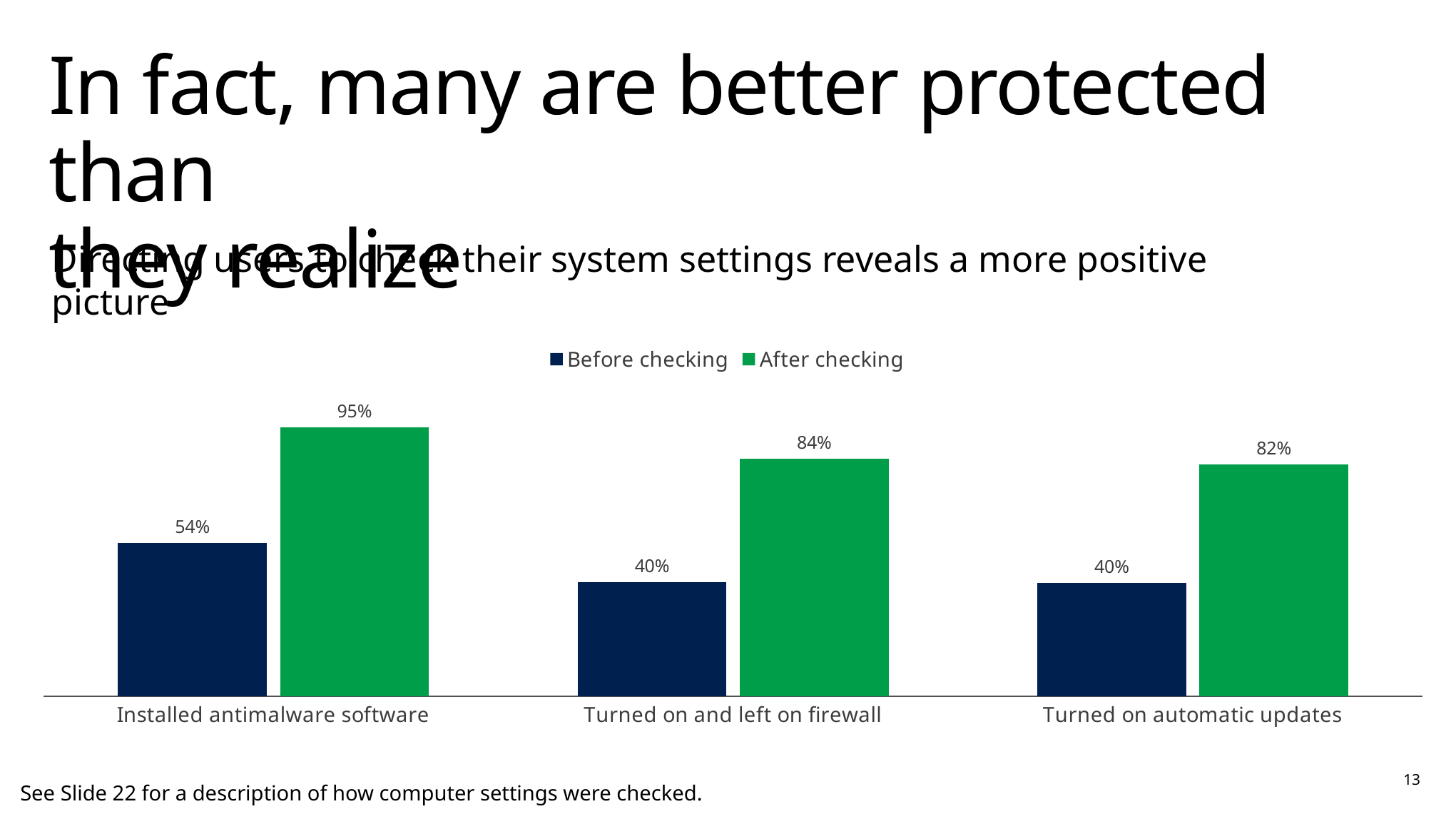
What is the 'Before checking' value for 'Turned on and left on firewall'? 40% Which category has the highest 'After checking' value? Installed antimalware software How many series does the legend list? 2 What is the difference between the 'After checking' and 'Before checking' values for 'Installed antimalware software'? 41% What kind of chart is shown on the slide? Bar chart How many categories are shown on the x axis? 3 What is the 'Before checking' value for 'Installed antimalware software'? 54% What is the difference between the 'After checking' and 'Before checking' values for 'Turned on and left on firewall'? 44% Which category has the lowest 'After checking' value? Turned on automatic updates What is the 'After checking' value for 'Turned on automatic updates'? 82% What is the 'After checking' value for 'Turned on and left on firewall'? 84% Which is larger: the 'After checking' value for 'Turned on and left on firewall' or for 'Turned on automatic updates'? Turned on and left on firewall